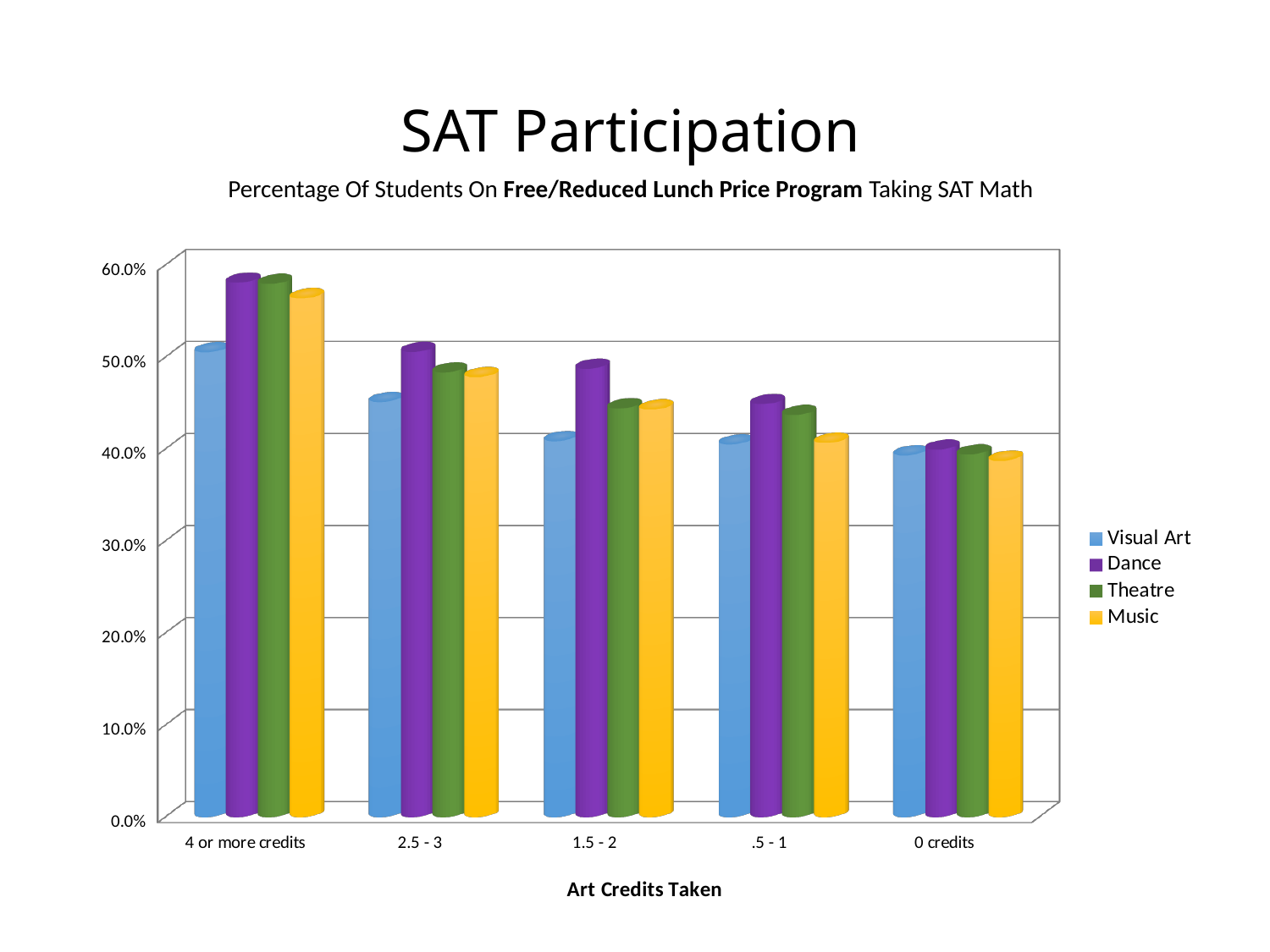
Is the value for Visual Art at 2.5 - 3 credits greater or less than 50.0%? less At 2.5 - 3 credits, which is larger: Dance or Visual Art? Dance For the Visual Art series, which credit category has the highest value? 4 or more credits What kind of chart is shown on the slide? bar chart Is the value for Dance at 4 or more credits greater or less than 50.0%? greater How many series does the legend list? 4 Is the value for Dance at 1.5 - 2 credits greater or less than 40.0%? greater For the Dance series, which credit category has the lowest value? 0 credits How many art-credit categories are shown on the x axis? 5 What is the title of the x axis? Art Credits Taken Which series is shown in purple in the legend? Dance